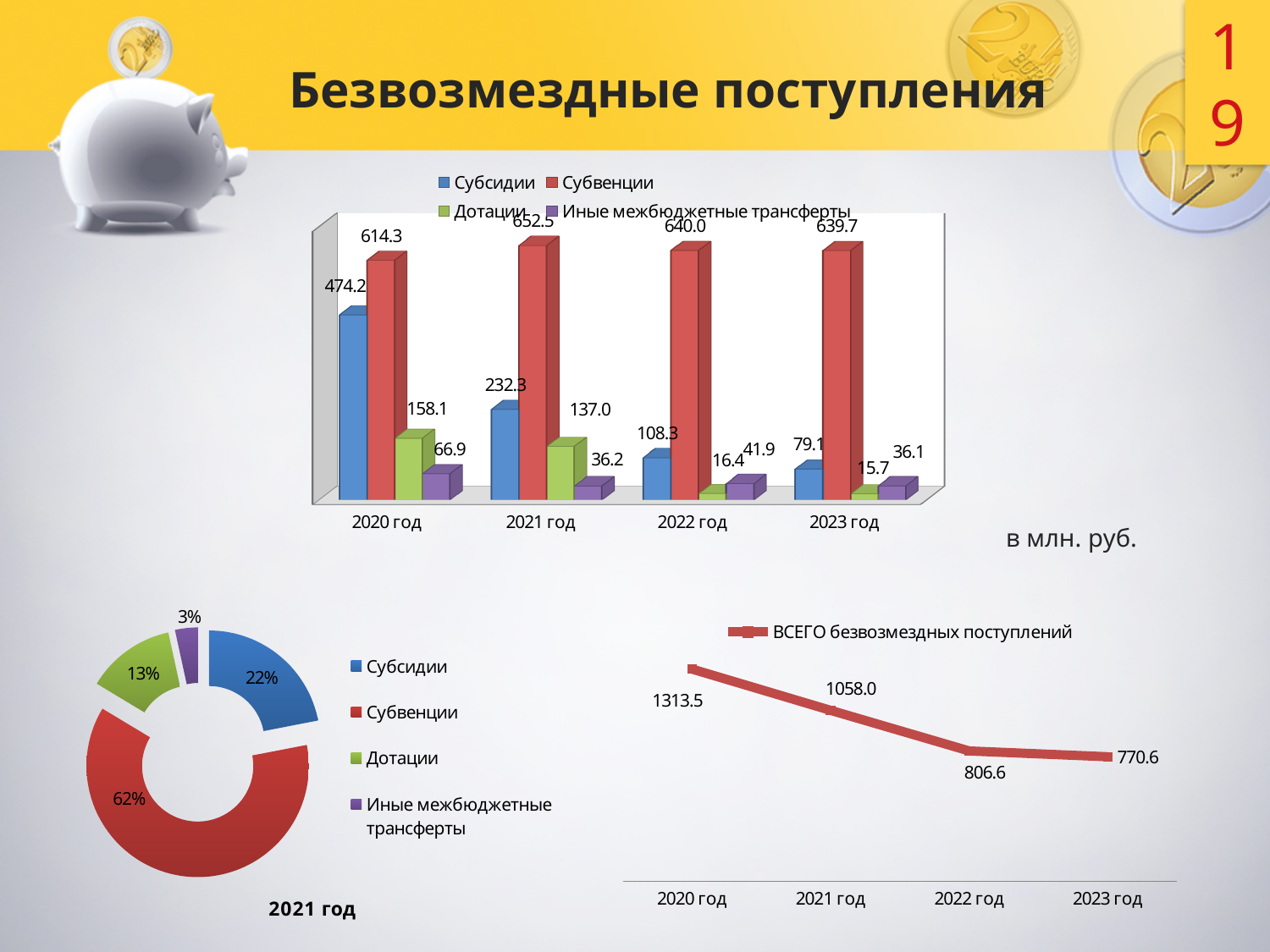
In the top bar chart, which year has the highest value for Субсидии? 2020 год In the top bar chart, which is larger in 2022 год: Дотации or Иные межбюджетные трансферты? Иные межбюджетные трансферты In the donut chart for 2021 год, which category has the smallest share? Иные межбюджетные трансферты In the donut chart for 2021 год, what share does Субвенции have? 62% In the top bar chart, how do the values for Субсидии change from 2020 год to 2023 год? They fall In the line chart ВСЕГО безвозмездных поступлений, what is the value for 2022 год? 806.6 How many series does the legend of the top bar chart list? 4 In the top bar chart, what is the value for Субсидии in 2020 год? 474.2 In the top bar chart, what is the value for Дотации in 2023 год? 15.7 In the top bar chart, what is the difference between Субвенции and Субсидии in 2020 год? 140.1 In the line chart ВСЕГО безвозмездных поступлений, what is the difference between 2020 год and 2023 год? 542.9 In the top bar chart, what is the value for Субвенции in 2021 год? 652.5